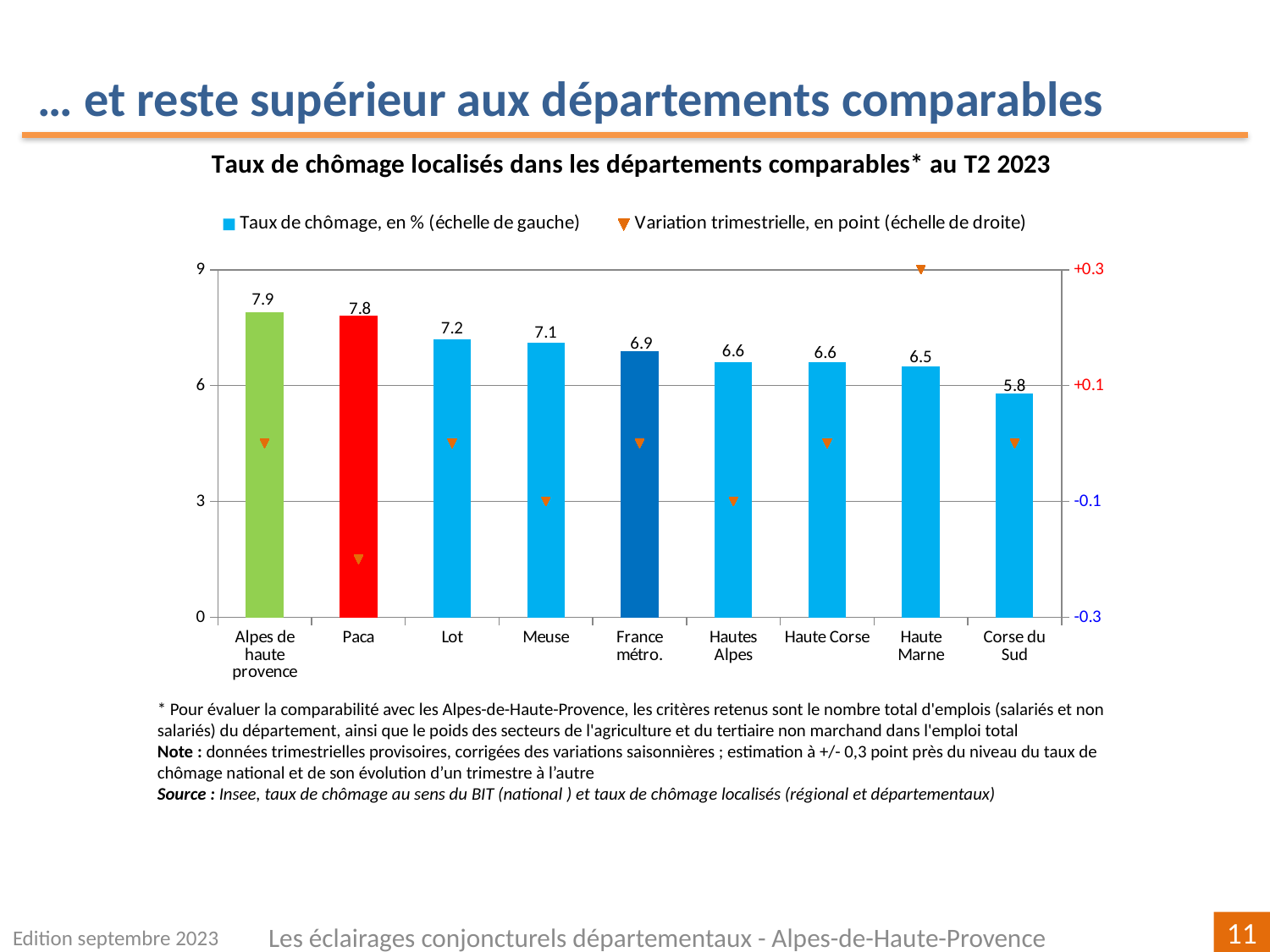
Which category has the highest unemployment rate bar? Alpes de haute provence How many series does the legend list? 2 What is the difference between the unemployment rates of Alpes de haute provence and Corse du Sud? 2.1 What is the unemployment rate (Taux de chômage) shown for Alpes de haute provence? 7.9 What is the unemployment rate shown for Corse du Sud? 5.8 Which category has the lowest unemployment rate bar? Corse du Sud Which has a higher unemployment rate, Lot or Meuse? Lot How many categories (departments/areas) are shown on the x axis? 9 Is the quarterly variation for Paca greater or less than -0.1 on the right-hand scale? less What is the quarterly variation (Variation trimestrielle) shown for Haute Marne on the right-hand scale? +0.3 What is the unemployment rate shown for France métro.? 6.9 What kind of chart is used to show the unemployment rates? Bar chart